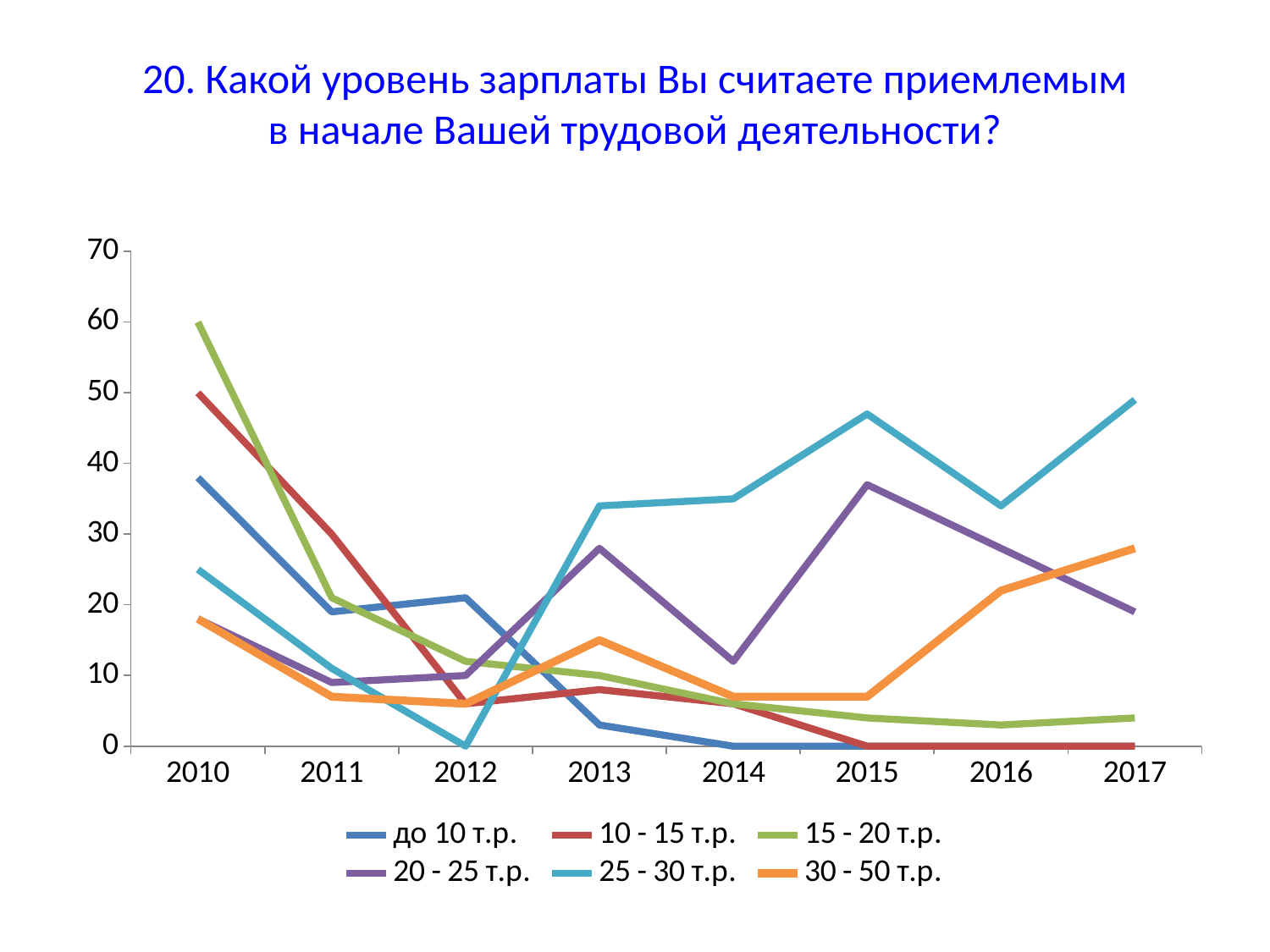
How many years are shown along the x axis? 8 Is the value for "30 - 50 т.р." in 2017 greater or less than 30? less What is the value for the "10 - 15 т.р." series in 2016? 0 In 2017, which is larger: the value for "25 - 30 т.р." or for "20 - 25 т.р."? 25 - 30 т.р. Is the value for "15 - 20 т.р." in 2010 greater or less than 50? greater How many series does the legend list? 6 Is the value for "25 - 30 т.р." in 2015 greater or less than 40? greater What is the value for the "25 - 30 т.р." series in 2012? 0 Does the "15 - 20 т.р." series rise or fall overall from 2010 to 2017? fall Which series has the highest value in 2010? 15 - 20 т.р. What kind of chart is shown on the slide? line chart Which series has the highest value in 2017? 25 - 30 т.р.